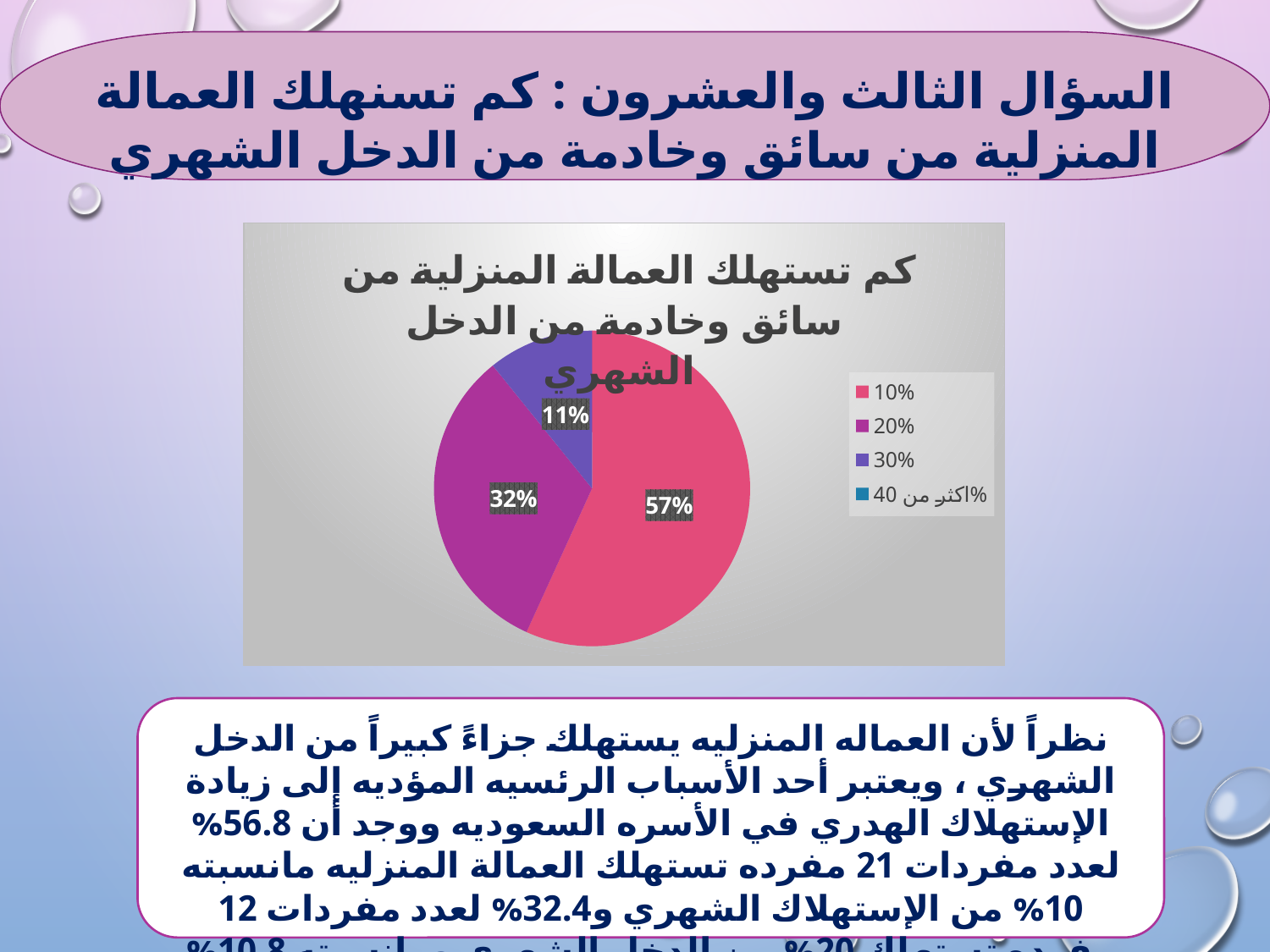
How many entries does the legend list? 4 What kind of chart is shown on the slide? pie chart What is the difference between the shares of the "10%" and "20%" categories? 25 percentage points Which is larger, the slice for "20%" or the slice for "30%"? 20% Which of the labelled slices is the smallest? 30% What colour is the slice for the "10%" category? pink/red Which category has the largest slice of the pie? 10% What is the difference between the shares of the "20%" and "30%" categories? 21 percentage points What share of the pie does the "20%" category have? 32% What share of the pie does the "10%" category have? 57% What is the legend entry for the last (fourth) category? اكثر من 40% What share of the pie does the "30%" category have? 11%